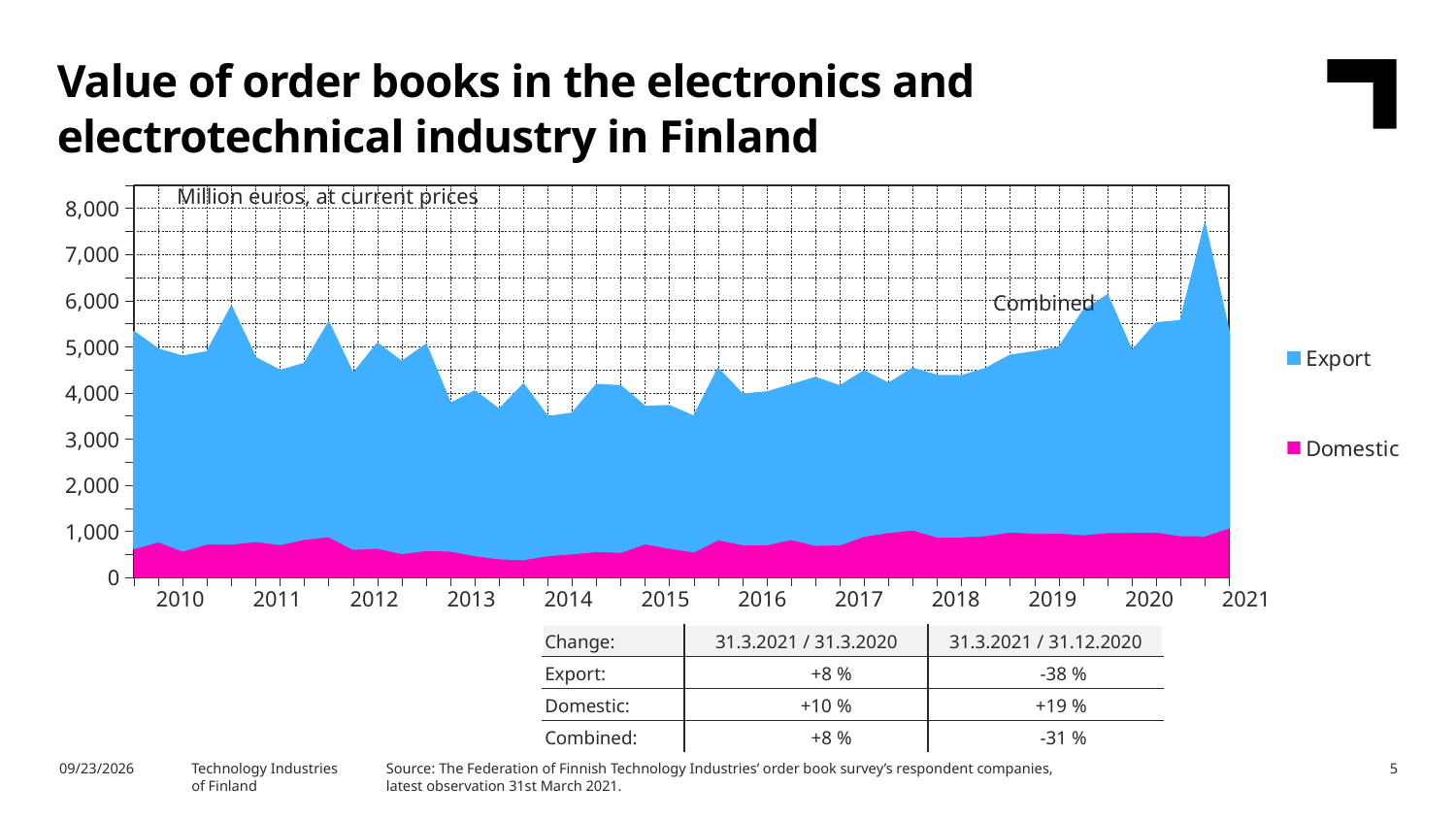
How many series does the chart legend list? 2 Is the peak combined value reached in late 2020 greater or less than 7,000? greater Does the combined order book value generally rise or fall from 2018 to 2020? rise How many year labels appear on the x axis of the chart? 12 Which two series are listed in the chart legend? Export and Domestic Which series is larger throughout the chart, Export or Domestic? Export What kind of chart is shown on the slide? Stacked area chart Is the Domestic value in 2014 greater or less than 1,000? less Is the combined value at the start of 2015 greater or less than 4,000? less What unit is stated for the values on the chart? Million euros, at current prices In which year does the combined order book value reach its highest peak? 2020